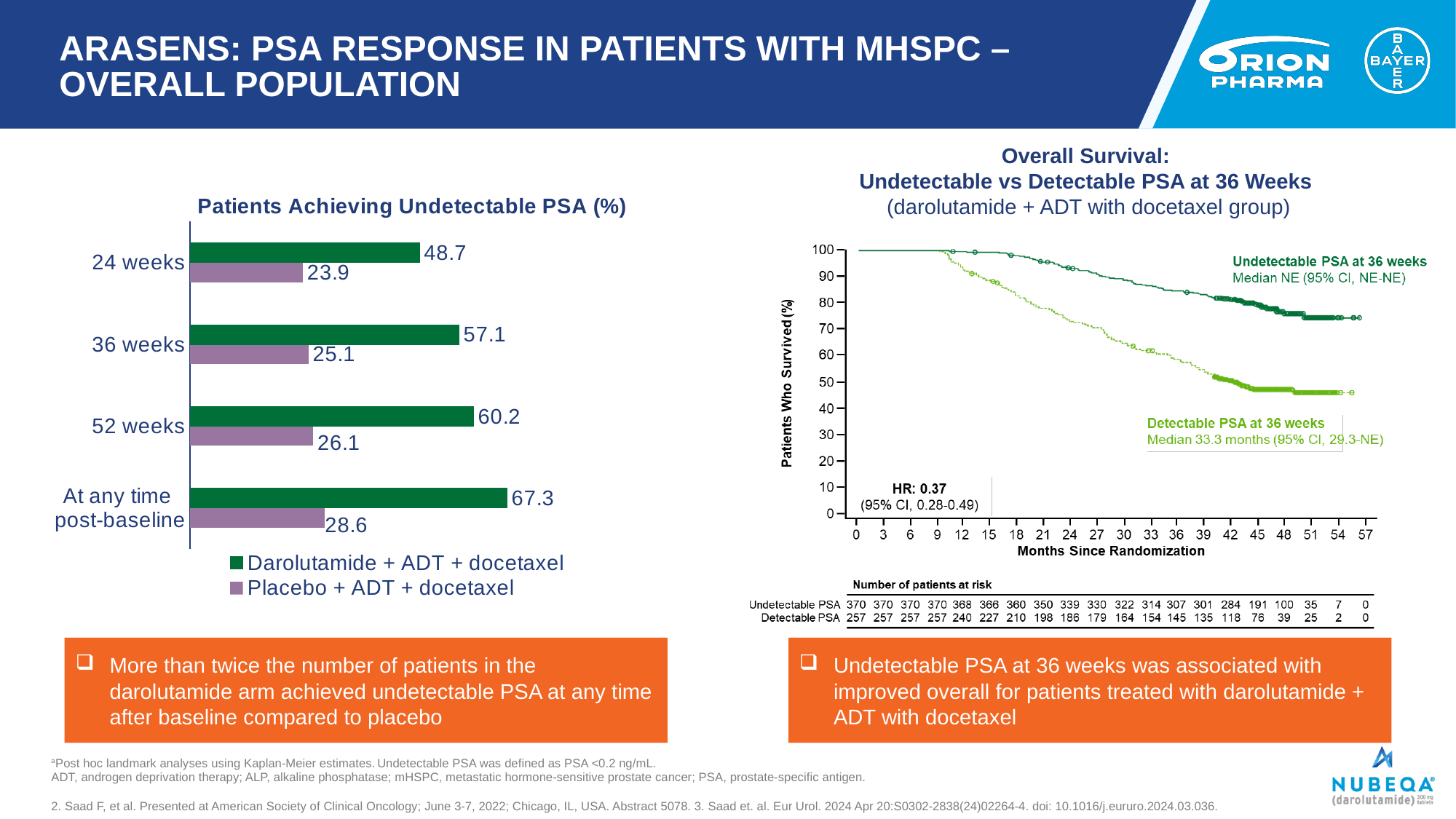
How many categories are shown in the 'Patients Achieving Undetectable PSA (%)' chart? 4 What kind of chart is the 'Patients Achieving Undetectable PSA (%)' chart? Bar chart In the 'Patients Achieving Undetectable PSA (%)' chart, do the Darolutamide + ADT + docetaxel values rise or fall from 24 weeks to any time post-baseline? Rise In the 'Patients Achieving Undetectable PSA (%)' chart, which category has the highest value for Darolutamide + ADT + docetaxel? At any time post-baseline In the 'Patients Achieving Undetectable PSA (%)' chart, which is larger at 36 weeks: Darolutamide + ADT + docetaxel or Placebo + ADT + docetaxel? Darolutamide + ADT + docetaxel In the Overall Survival chart on the right, what is the hazard ratio (HR) shown? 0.37 In the 'Patients Achieving Undetectable PSA (%)' chart, what is the value for Darolutamide + ADT + docetaxel at 24 weeks? 48.7 In the 'Patients Achieving Undetectable PSA (%)' chart, what is the difference between the Darolutamide + ADT + docetaxel and Placebo + ADT + docetaxel values at 52 weeks? 34.1 In the 'Patients Achieving Undetectable PSA (%)' chart, which category has the lowest value for Placebo + ADT + docetaxel? 24 weeks In the 'Patients Achieving Undetectable PSA (%)' chart, what is the value for Placebo + ADT + docetaxel at 36 weeks? 25.1 In the 'Patients Achieving Undetectable PSA (%)' chart, what is the value for Darolutamide + ADT + docetaxel at any time post-baseline? 67.3 How many series does the legend of the 'Patients Achieving Undetectable PSA (%)' chart list? 2